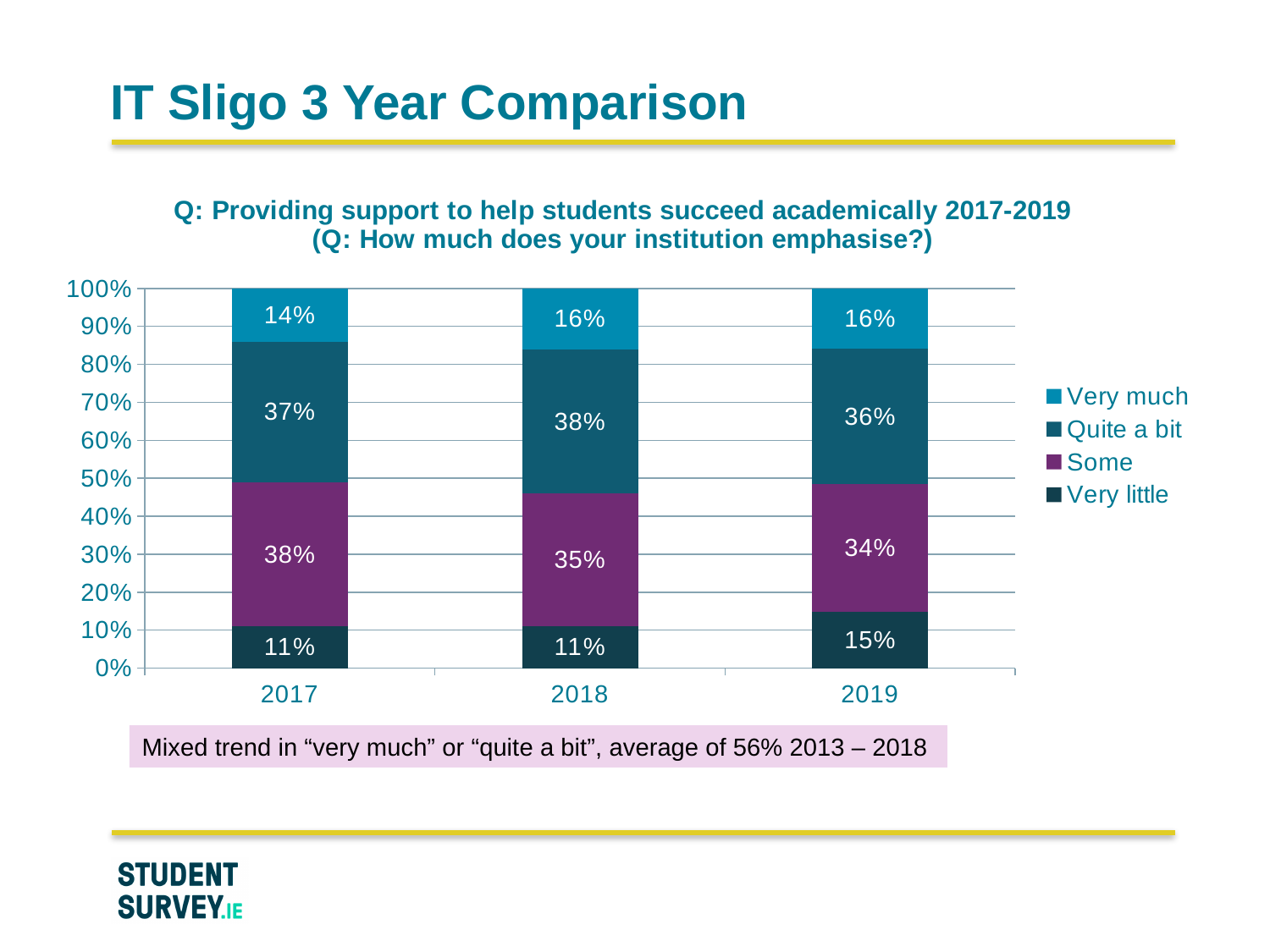
What is the value for "Very little" in 2019? 15% What kind of chart is shown? Stacked bar chart How many years are shown on the x axis? 3 What is the value for "Quite a bit" in 2018? 38% What is the value for "Some" in 2019? 34% In which year is the "Very little" share highest? 2019 What percentage of respondents answered "Very much" in 2017? 14% In which year is the "Some" share lowest? 2019 What is the difference between the "Some" value in 2017 and in 2018? 3% Which is larger: "Quite a bit" in 2017 or "Quite a bit" in 2019? Quite a bit in 2017 How many series does the legend list? 4 What is the combined value of "Very much" and "Quite a bit" in 2018? 54%